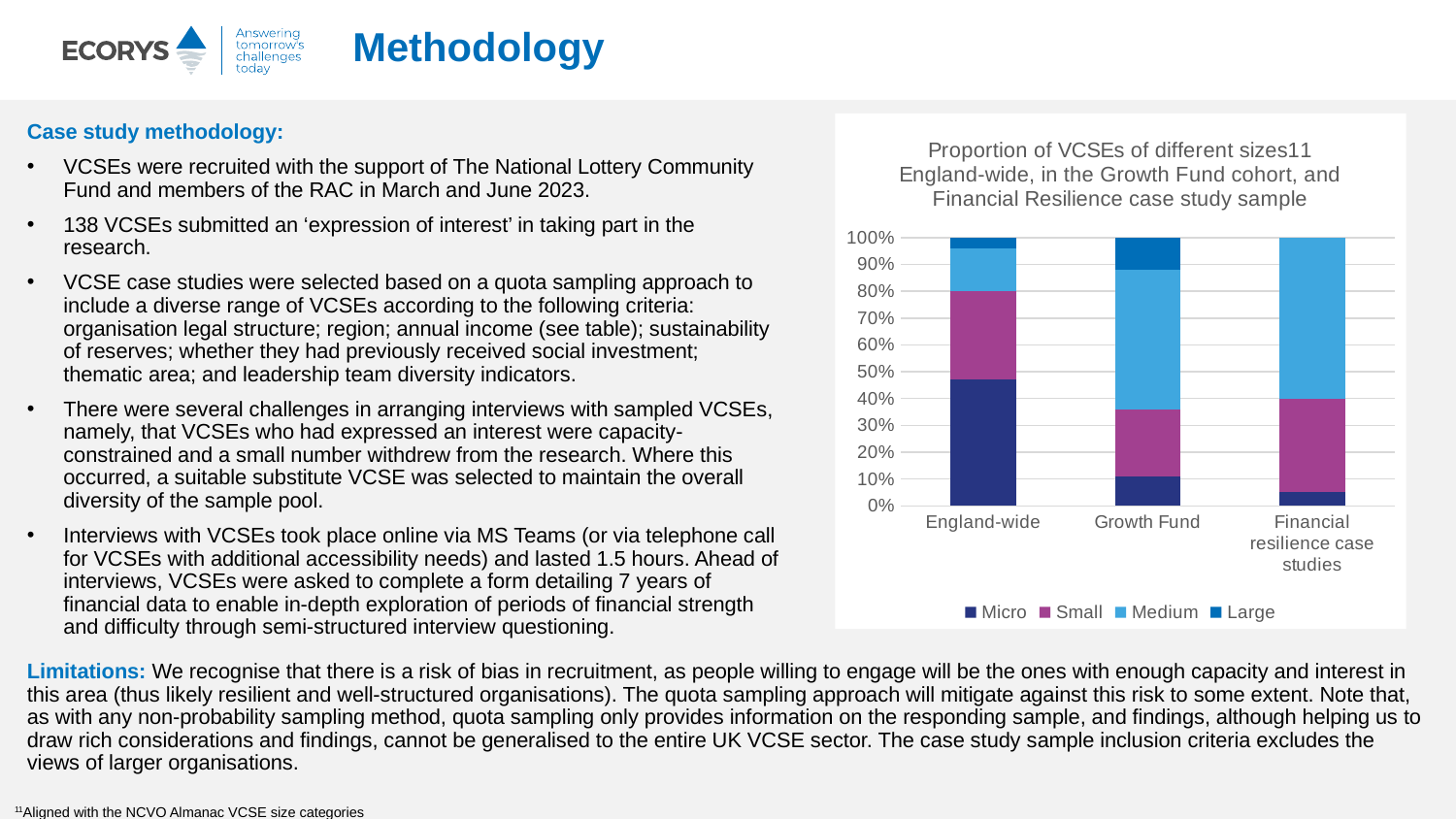
Is the Micro share for England-wide greater or less than 40%? greater How many series does the chart's legend list? 4 What kind of chart is shown on the slide? Stacked bar chart Is the Medium share for Financial resilience case studies greater or less than 50%? greater Which category has the largest Micro share? England-wide Which category has no Large segment in its bar? Financial resilience case studies Is the Micro share larger for England-wide or for Growth Fund? England-wide Which category has the smallest Micro share? Financial resilience case studies Is the Micro share for Financial resilience case studies greater or less than 10%? less How many categories are shown on the x axis of the chart? 3 Which series are listed in the chart's legend? Micro, Small, Medium, Large